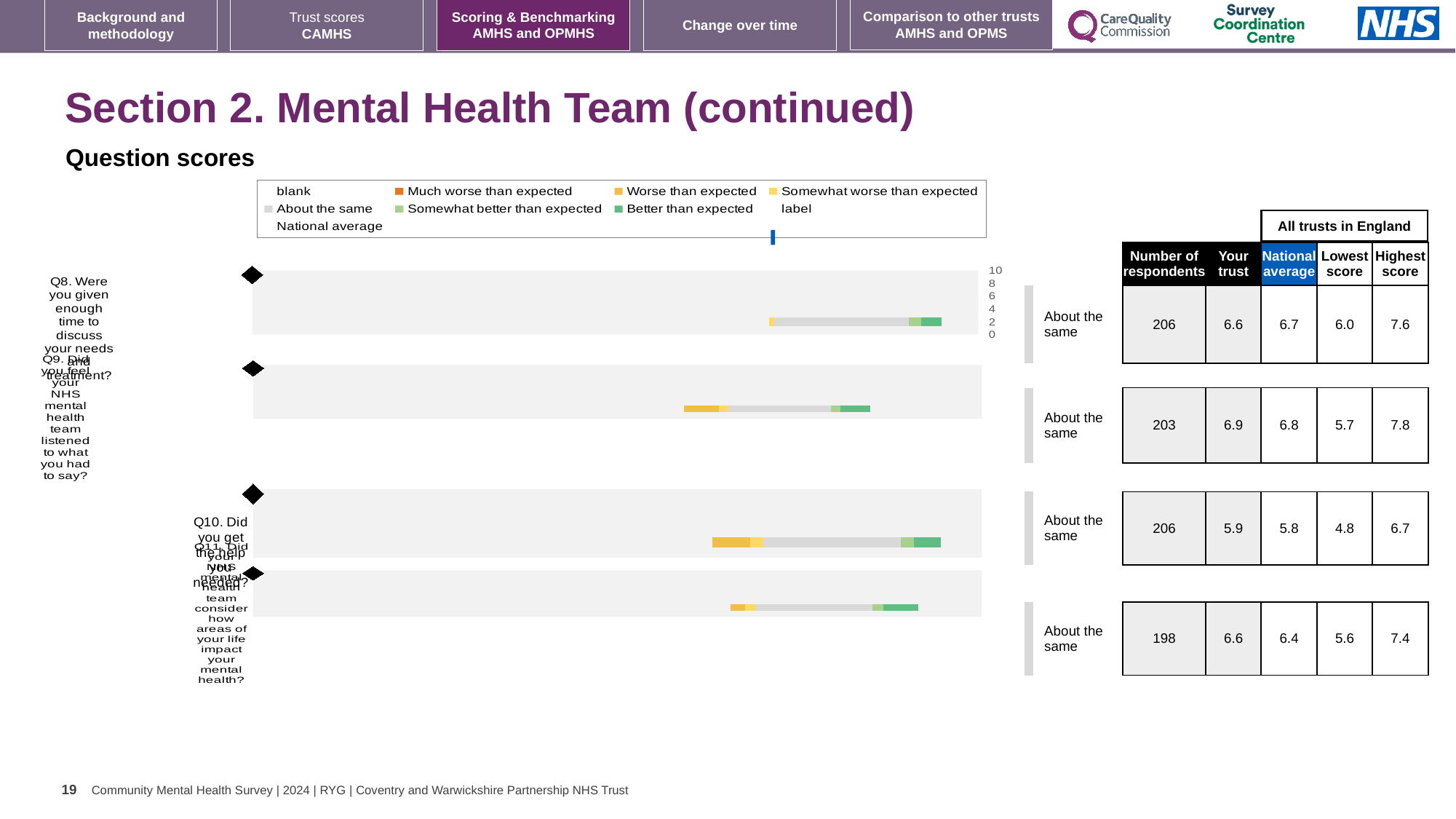
Which question has the highest 'Your trust' score? Q9 What is the highest score across all trusts in England for Q8 (Were you given enough time to discuss your needs and treatment)? 7.6 What is the maximum value shown on the chart's score axis? 10 What is the national average score for Q10 (Did you get the help you needed)? 5.8 Which question has the lowest 'Your trust' score? Q10 How many questions (bars) are plotted in the question scores chart? 4 Which legend entry is shown in orange? Much worse than expected What is the difference between the highest score (6.7) and the lowest score (4.8) for Q10? 1.9 What is the number of respondents for Q11 (Did your NHS mental health team consider how areas of your life impact your mental health)? 198 What is the 'Your trust' score for Q9 (Did you feel your NHS mental health team listened to what you had to say)? 6.9 For Q8, which is larger: the 'Your trust' score or the national average? National average What kind of chart is used to show the question scores? bar chart